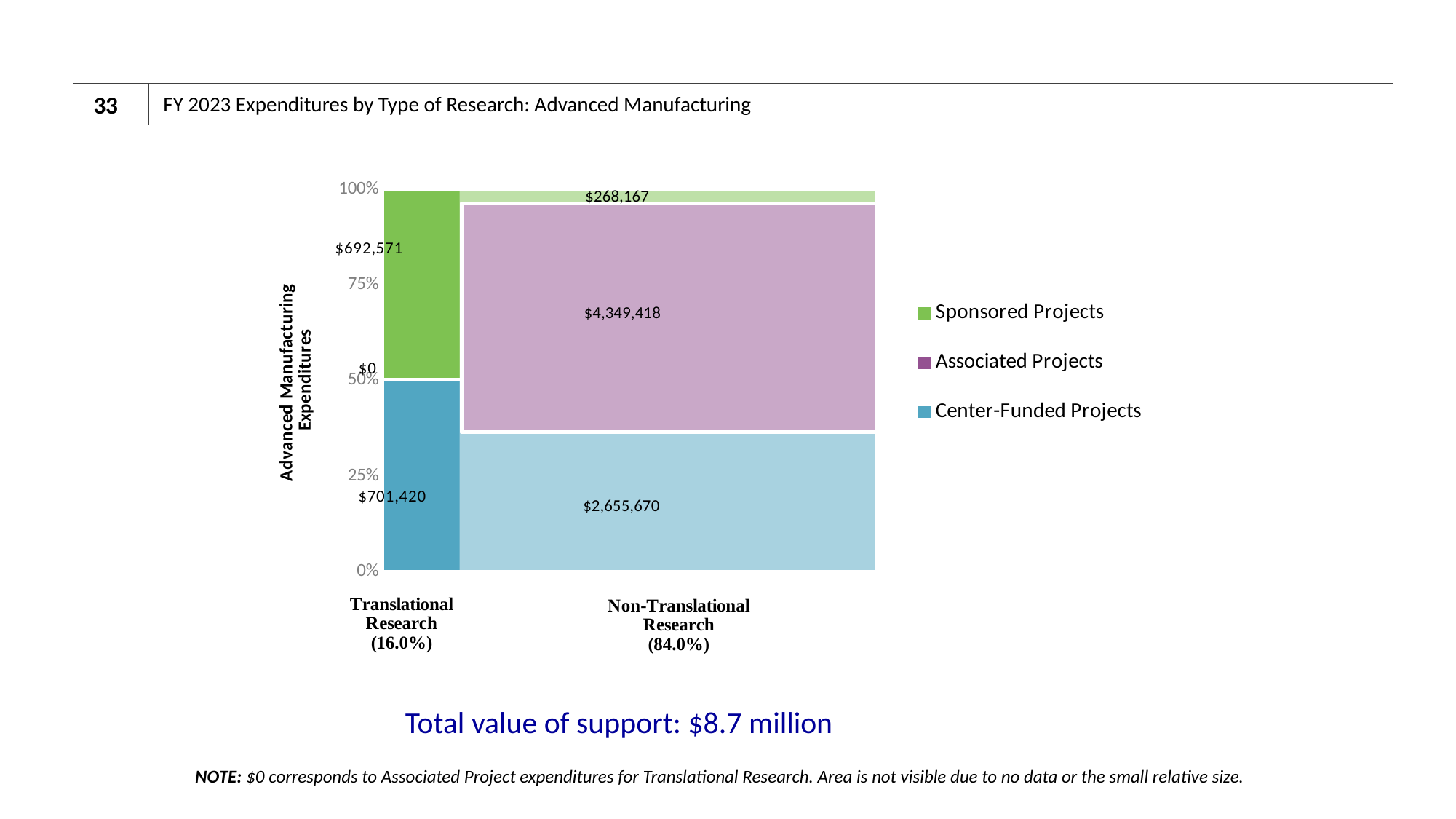
Which is larger: the Sponsored Projects expenditure for Translational Research or for Non-Translational Research? Translational Research What is the Center-Funded Projects expenditure for Non-Translational Research? $2,655,670 How many series does the legend list? 3 What is the Sponsored Projects expenditure for Translational Research? $692,571 What is the Associated Projects expenditure for Non-Translational Research? $4,349,418 Which series has the smallest expenditure for Non-Translational Research? Sponsored Projects What is the total expenditure for Non-Translational Research across all three series? $7,273,255 What is the Center-Funded Projects expenditure for Translational Research? $701,420 What is the Associated Projects expenditure for Translational Research? $0 Which series has the largest expenditure for Non-Translational Research? Associated Projects What is the difference between the Center-Funded Projects expenditures for Non-Translational Research and Translational Research? $1,954,250 What share of Advanced Manufacturing expenditures does Translational Research represent, as shown in the category label? 16.0%